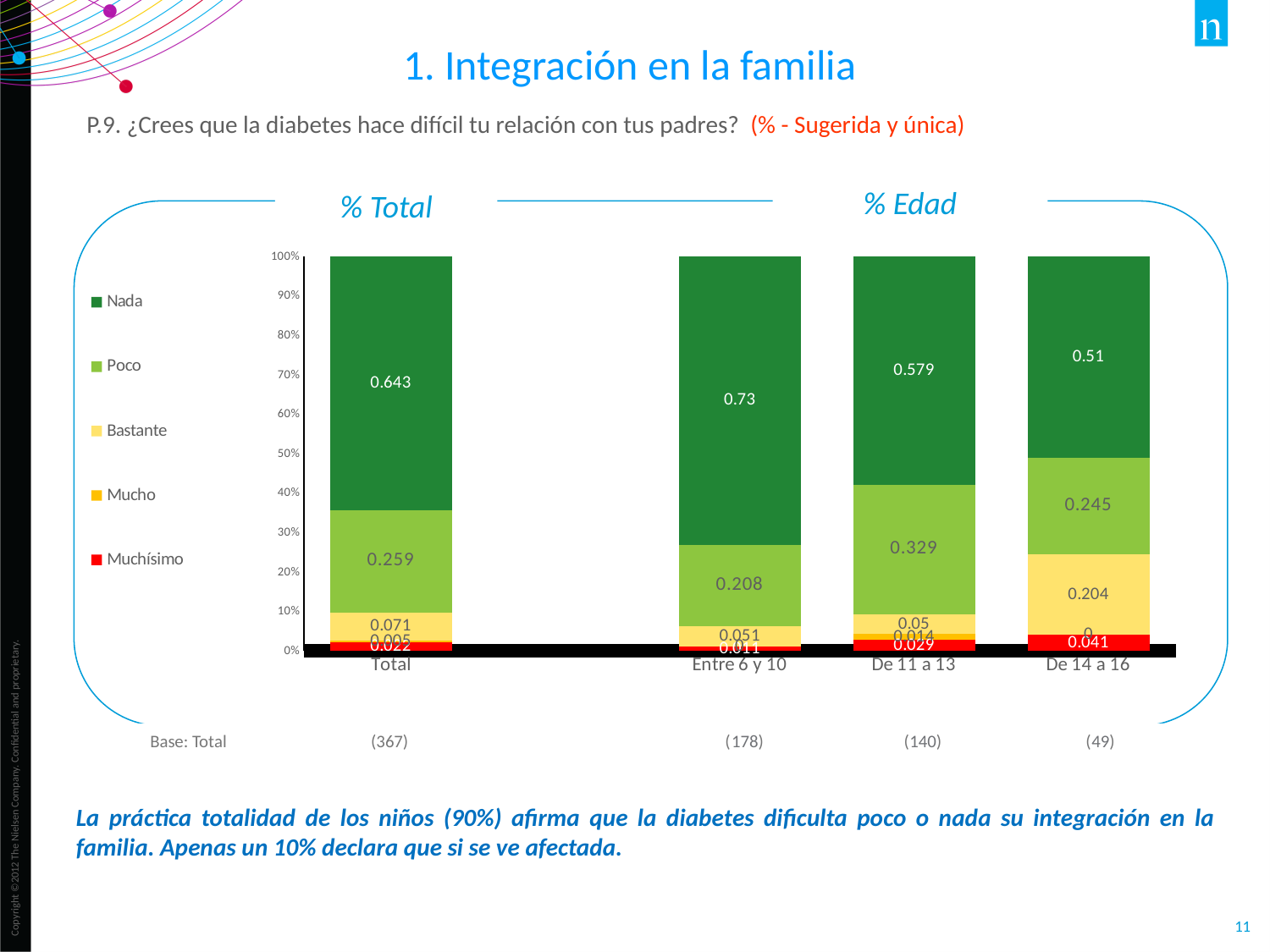
What is the value of the Mucho segment for the De 14 a 16 bar? 0 Which has the larger Poco value, Total or De 14 a 16? Total What is the value of the Nada segment for the Total bar? 0.643 What is the value of the Poco segment for the De 11 a 13 bar? 0.329 How many categories are shown on the x axis of the chart? 4 What kind of chart is shown on the slide? Stacked bar chart Which category has the highest Nada value? Entre 6 y 10 What is the difference between the Nada values for Entre 6 y 10 and De 14 a 16? 0.22 What is the value of the Nada segment for the Entre 6 y 10 bar? 0.73 How many series does the legend list? 5 What is the value of the Bastante segment for the De 14 a 16 bar? 0.204 Which category has the lowest Nada value? De 14 a 16